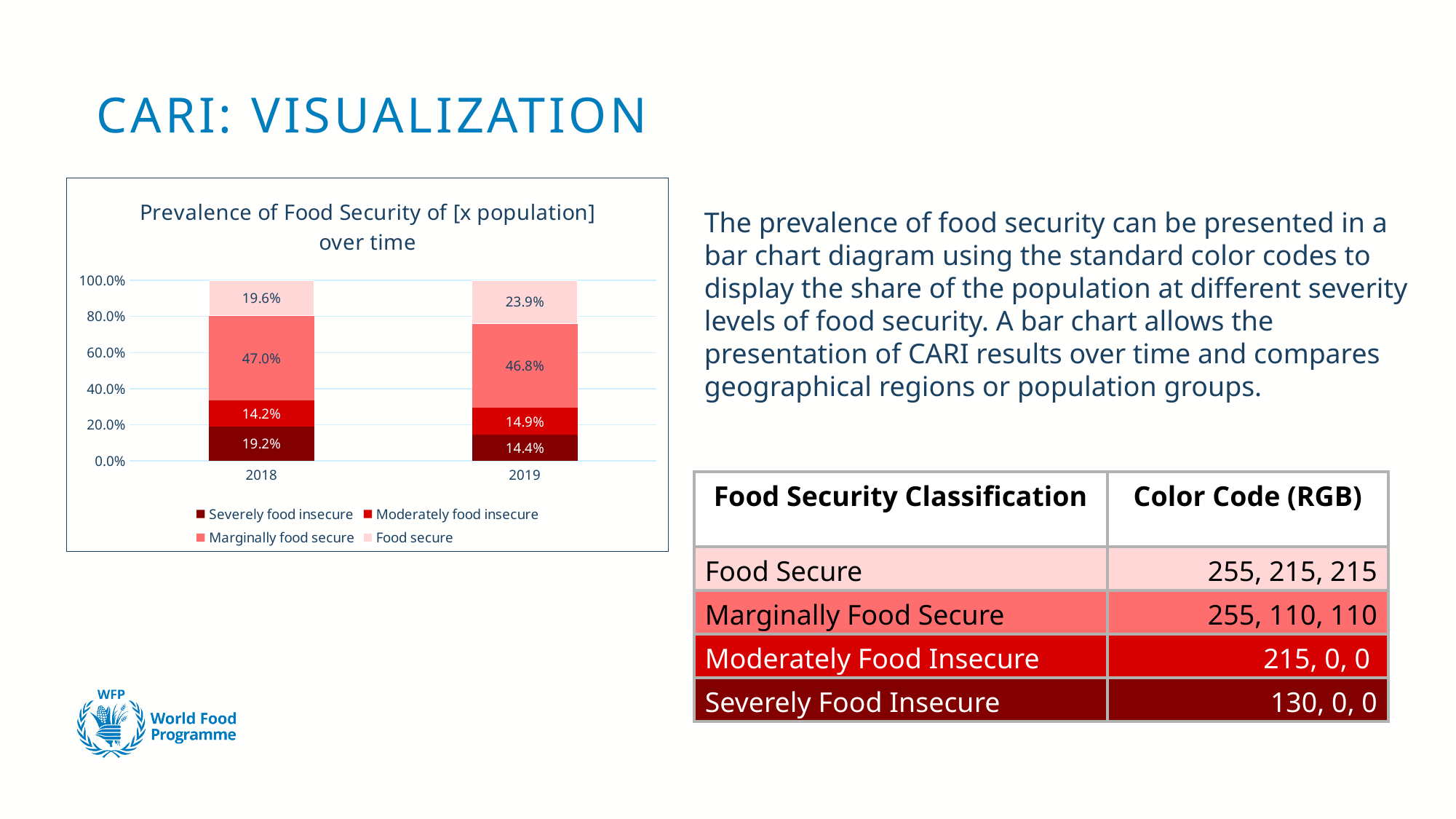
What is the difference between the Food secure values for 2019 and 2018? 4.3% Which series has the largest share in the 2018 bar? Marginally food secure What kind of chart is shown on the slide? Stacked bar chart What is the title of the chart? Prevalence of Food Security of [x population] over time What is the value for Marginally food secure in 2019? 46.8% How many series does the chart legend list? 4 Does the Severely food insecure share rise or fall from 2018 to 2019? Fall What is the value for Severely food insecure in 2018? 19.2% How many years are shown on the x axis of the chart? 2 Which series has the smallest share in the 2019 bar? Severely food insecure What is the value for Food secure in 2019? 23.9% What is the value for Moderately food insecure in 2018? 14.2%